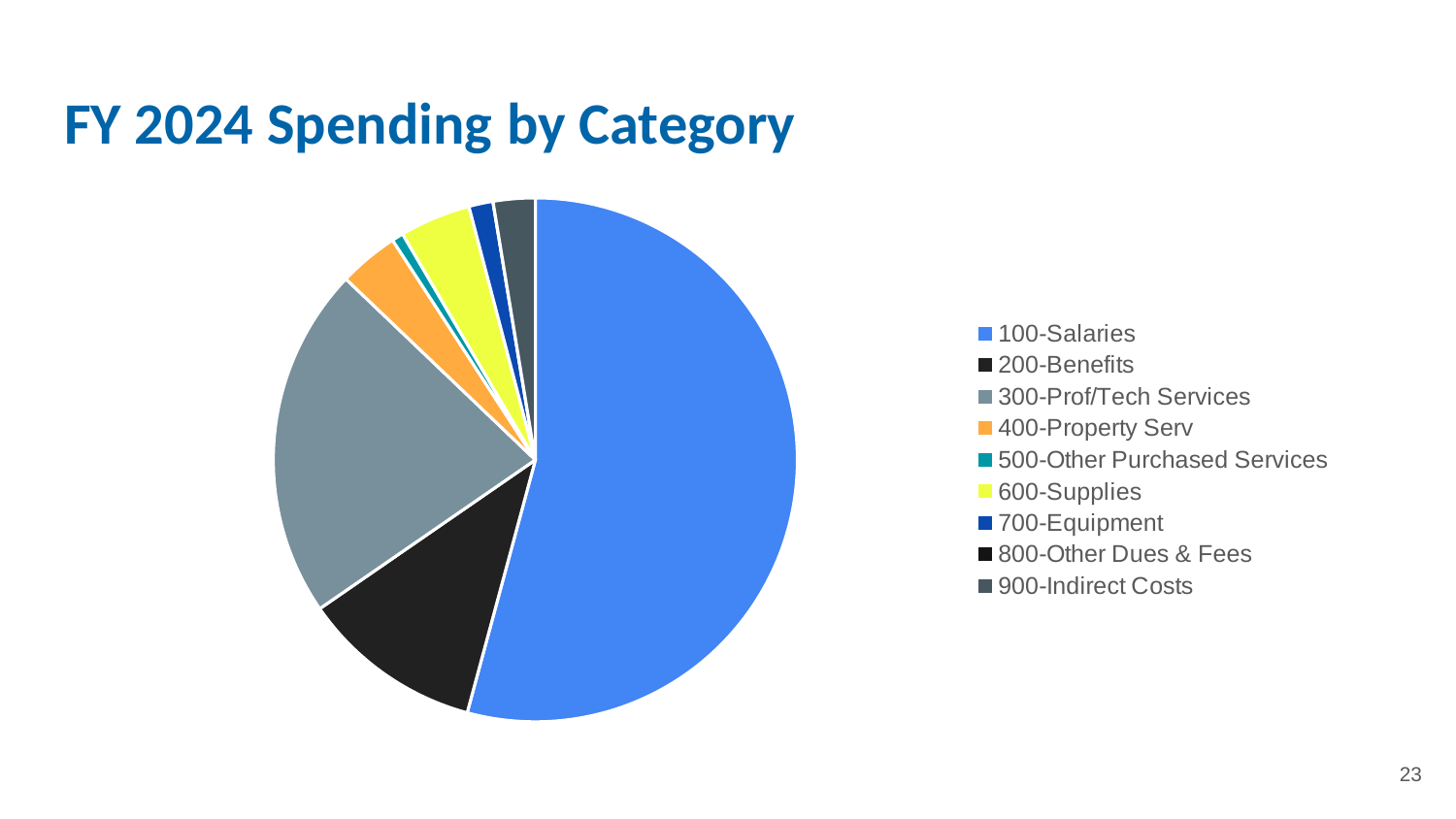
How many categories does the legend list? 9 Which is larger, the slice for 100-Salaries or the slice for 200-Benefits? 100-Salaries Which is larger, the slice for 600-Supplies or the slice for 500-Other Purchased Services? 600-Supplies Which category is shown in orange in the legend? 400-Property Serv Does the 100-Salaries slice take up more or less than half of the pie? more What is the title of the chart? FY 2024 Spending by Category Which category has the largest slice of the pie? 100-Salaries What kind of chart is shown on the slide? pie chart